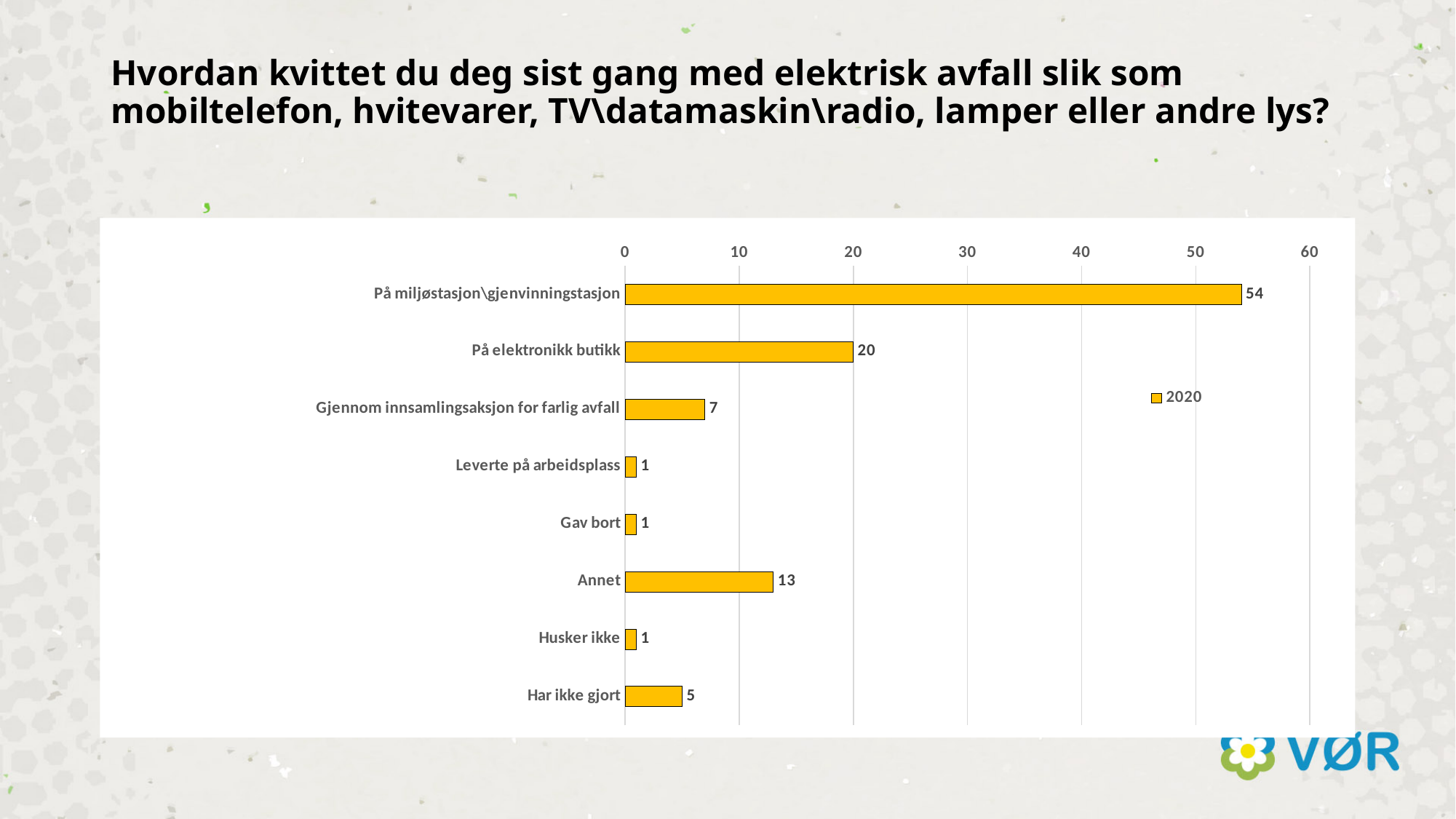
What kind of chart is shown on the slide? bar chart What is the value for 'Har ikke gjort'? 5 What is the value for 'Annet'? 13 What series name does the legend show? 2020 Which is larger, the value for 'Annet' or the value for 'Har ikke gjort'? Annet What is the value for 'På elektronikk butikk'? 20 Which category has the highest value? På miljøstasjon\gjenvinningstasjon What is the value for 'På miljøstasjon\gjenvinningstasjon'? 54 What is the difference between the values for 'På miljøstasjon\gjenvinningstasjon' and 'På elektronikk butikk'? 34 Is the value for 'På elektronikk butikk' greater or less than 30? less What is the difference between the values for 'Annet' and 'Gjennom innsamlingsaksjon for farlig avfall'? 6 How many categories are shown in the chart? 8